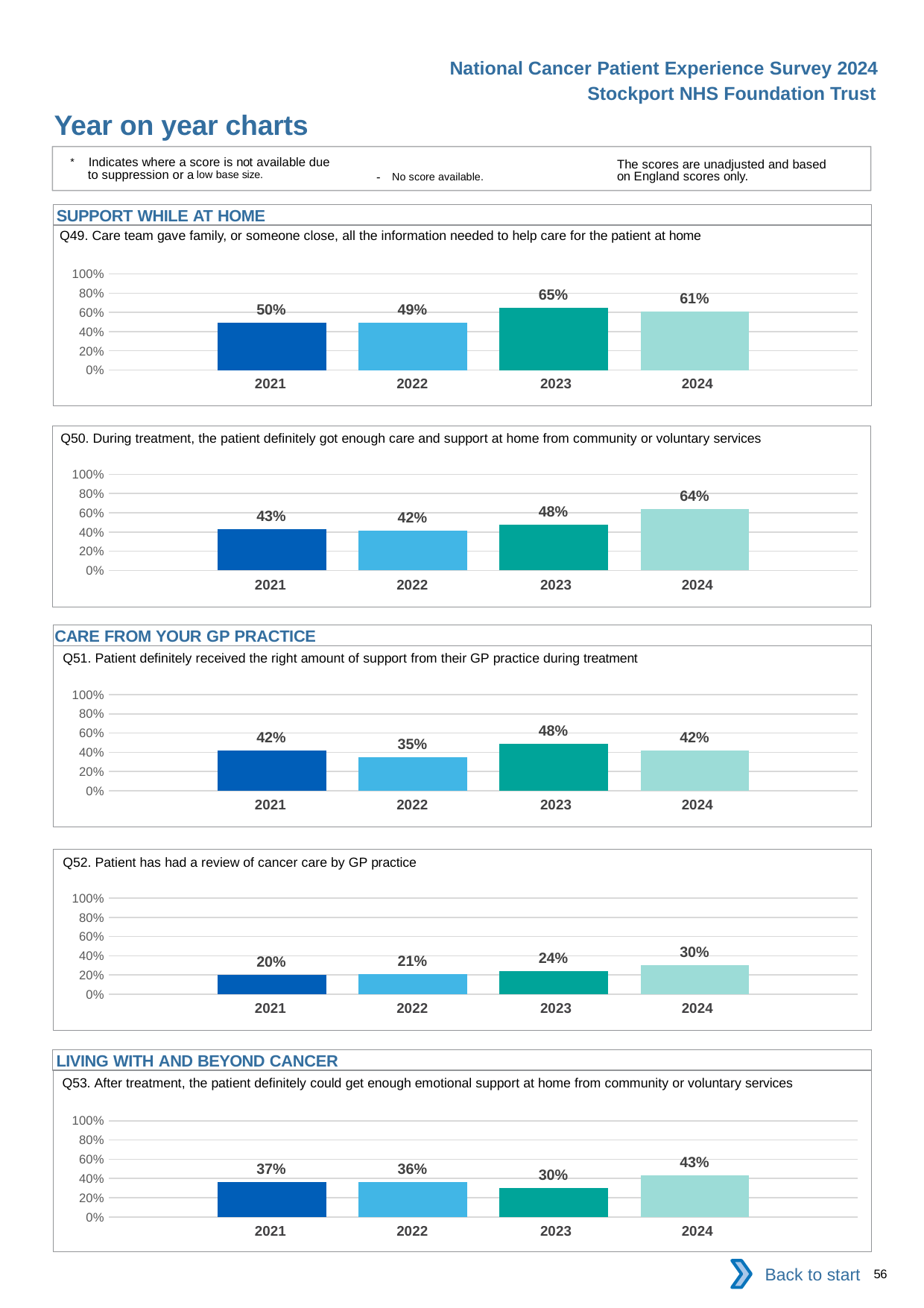
How many years are shown on the x axis of the Q52 chart? 4 In the Q53 chart, which is larger, the value for 2021 or the value for 2023? 2021 In the Q52 chart, do the values rise or fall from 2021 to 2024? rise What kind of chart is the Q49 chart? bar chart In the Q49 chart, what is the difference between the 2023 and 2022 values? 16% In the Q53 chart, what is the value for 2022? 36% Which section heading appears above the Q51 chart? CARE FROM YOUR GP PRACTICE In the Q52 chart, what is the difference between the 2024 and 2021 values? 10% In the Q49 chart, what is the value for 2023? 65% In the Q51 chart, which year has the lowest value? 2022 In the Q50 chart, is the value for 2024 greater or less than 60%? greater In the Q50 chart, which year has the highest value? 2024